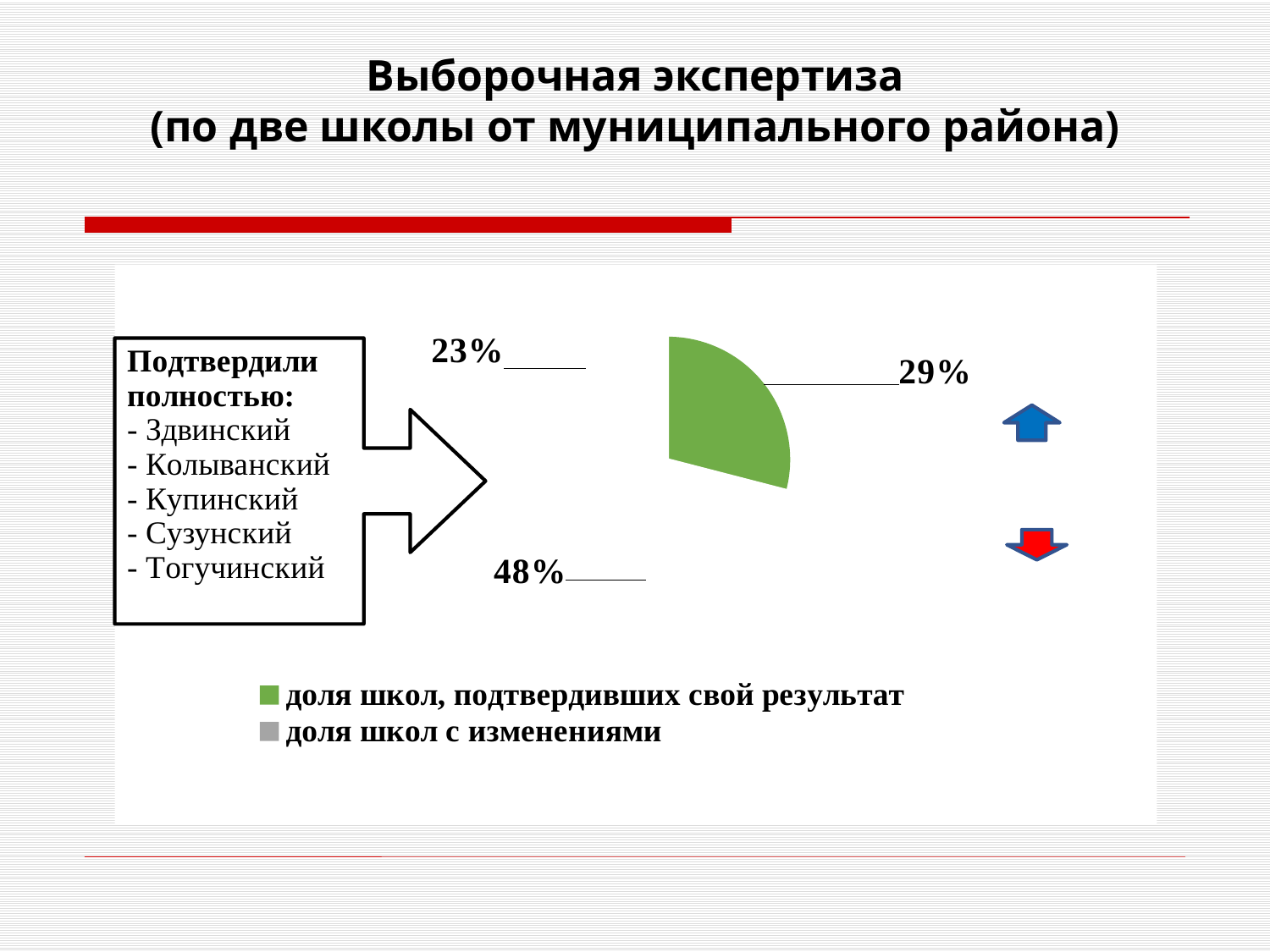
Which legend entry is shown with a green marker? доля школ, подтвердивших свой результат How many percentage data labels are shown on the pie chart? 3 Is the value labelled on the green slice greater or less than 25%? greater What value is labelled on the green slice of the pie chart? 29% How many entries does the chart legend list? 2 What is the largest percentage value labelled on the pie chart? 48% What is the smallest percentage value labelled on the pie chart? 23% What kind of chart is shown on the slide? pie chart What is the total of the three percentage labels shown on the pie chart? 100% What is the difference between the largest labelled value (48%) and the smallest labelled value (23%) on the pie chart? 25% What colour is the legend marker for "доля школ с изменениями"? grey Which is larger on the pie chart: the value labelled on the green slice or the 23% label? the green slice (29%)